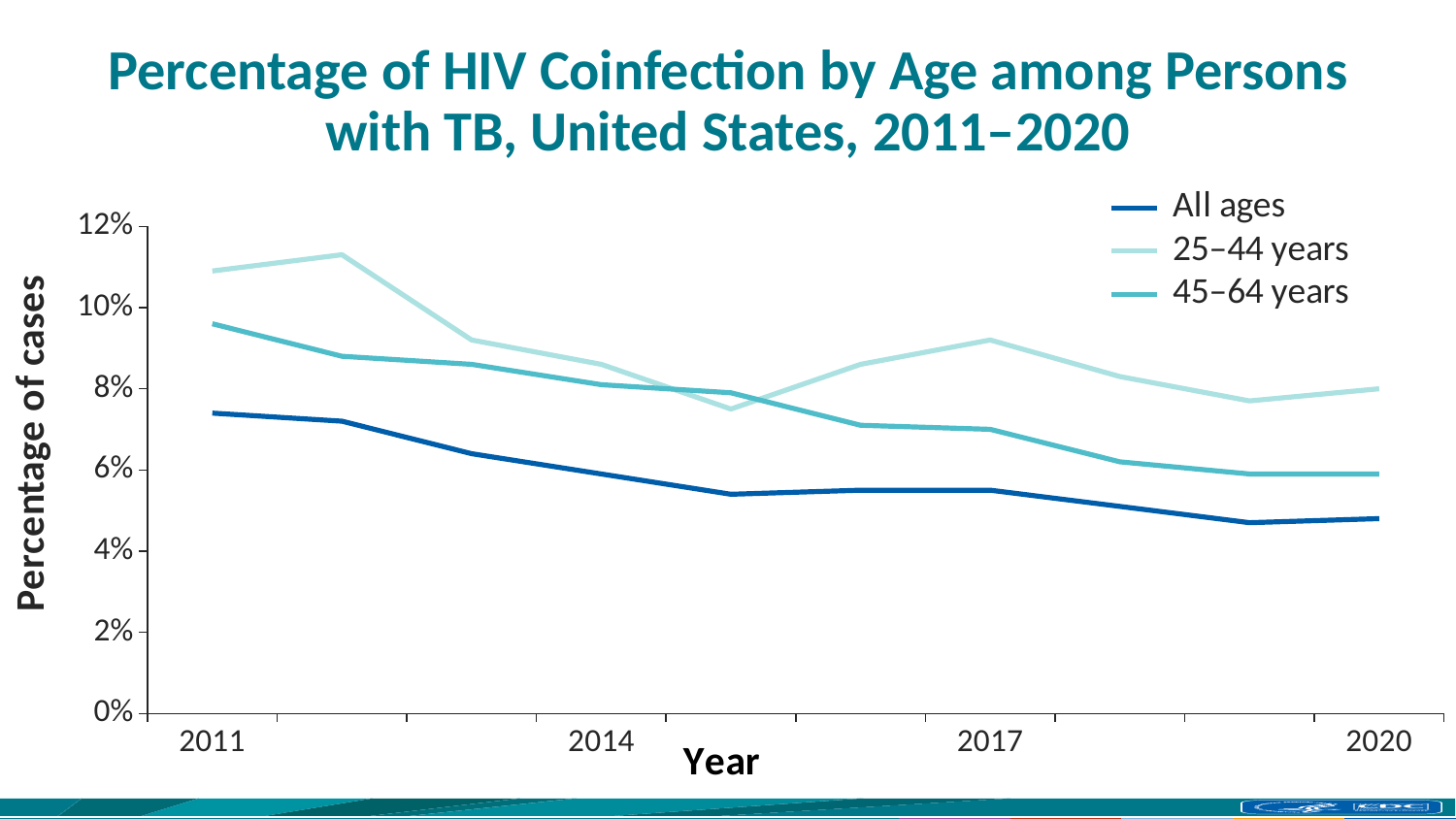
Is the value for 45–64 years in 2020 greater or less than 8%? less How many series does the legend list? 3 Does the All ages line rise or fall from 2011 to 2020? Falls What is the label of the y axis? Percentage of cases Is the value for All ages in 2020 greater or less than 6%? less Which series has the lowest values throughout the chart? All ages Is the value for All ages in 2011 greater or less than 6%? greater In 2017, which is larger: the value for 25–44 years or the value for 45–64 years? 25–44 years What kind of chart is shown on the slide? Line chart How many years are plotted along the x axis? 10